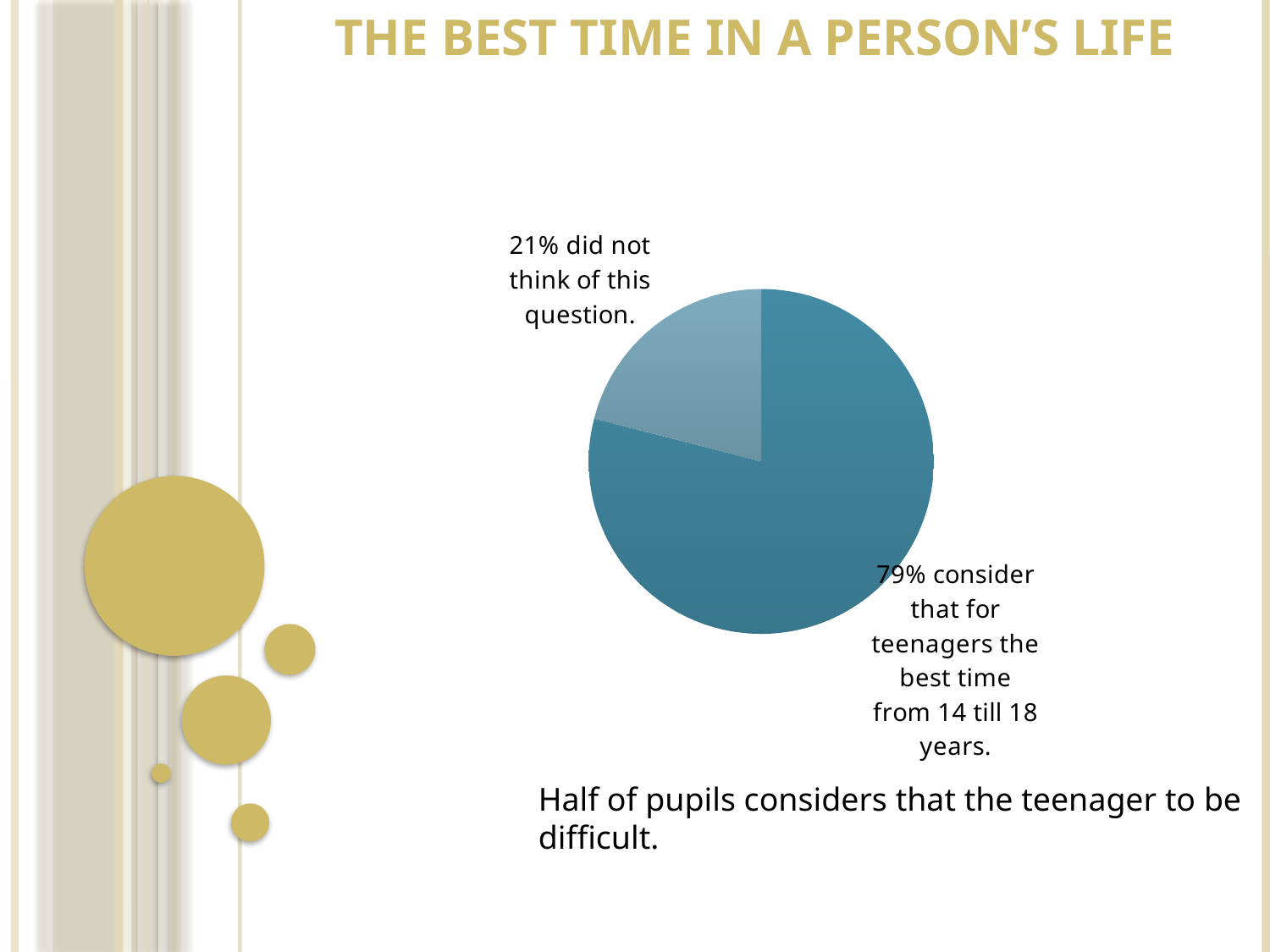
How many slices does the pie chart have? 2 Which slice of the pie chart is the largest? 79% consider that for teenagers the best time from 14 till 18 years What share of the pie does the slice for those who did not think of the question represent? 21% What is the difference in percentage points between the slice for those who consider 14 till 18 the best time and the slice for those who did not think of the question? 58 What percentage of respondents did not think of this question? 21% What percentage of respondents consider that for teenagers the best time is from 14 till 18 years? 79% What is the title of the slide containing the pie chart? THE BEST TIME IN A PERSON'S LIFE Which is larger: the share who consider 14 till 18 the best time, or the share who did not think of the question? the share who consider 14 till 18 the best time What kind of chart is shown on the slide? pie chart Which slice of the pie chart is shown in the lighter blue colour? 21% did not think of this question What is the total of the two slices shown in the pie chart? 100% Which slice of the pie chart is the smallest? 21% did not think of this question